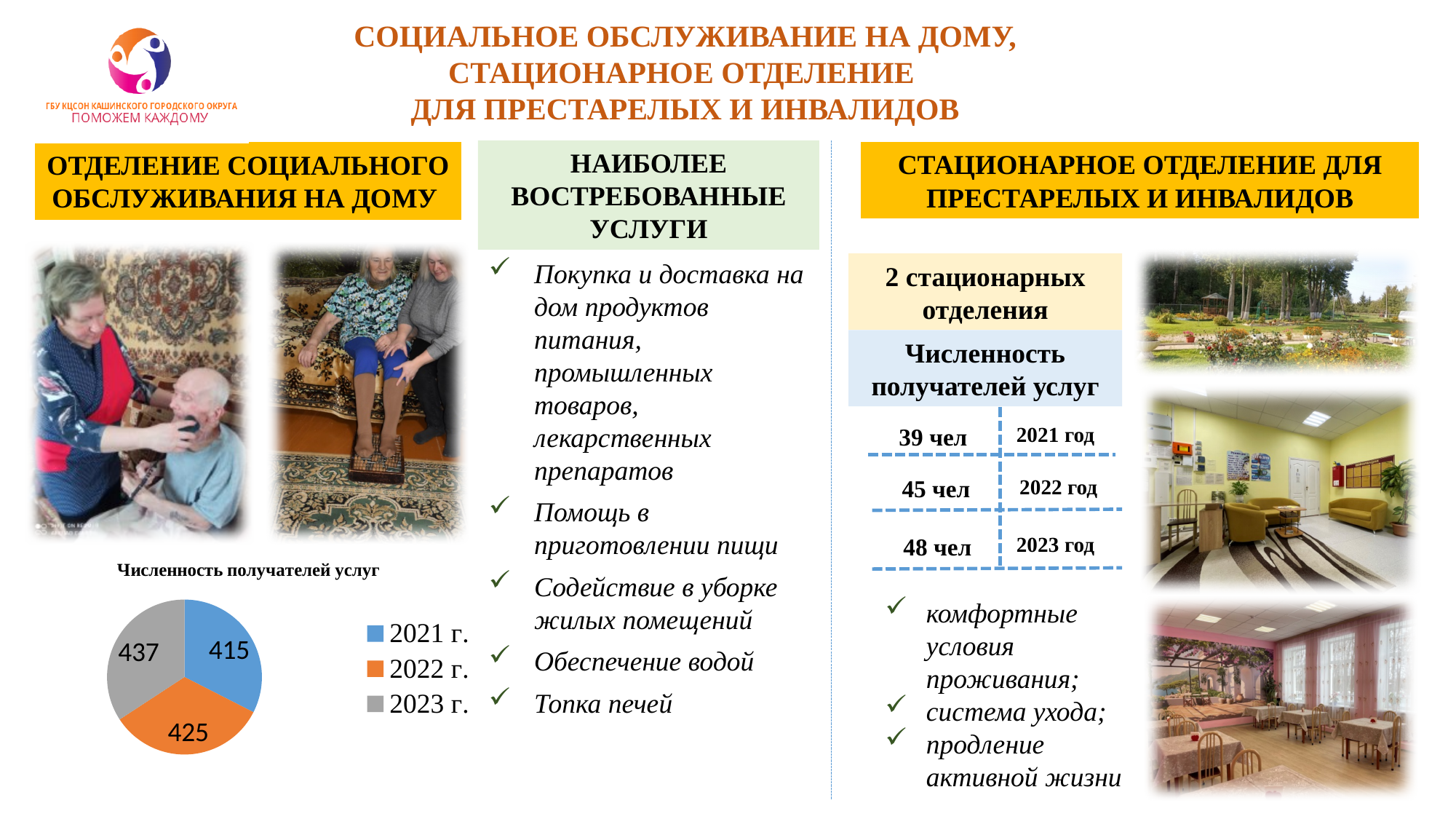
How many entries does the legend of the pie chart "Численность получателей услуг" list? 3 In the pie chart "Численность получателей услуг", which year has the largest slice? 2023 г. In the pie chart "Численность получателей услуг", what is the value for 2023 г.? 437 In the pie chart "Численность получателей услуг", what is the value for 2021 г.? 415 What kind of chart is shown under the heading "Численность получателей услуг" on the left of the slide? pie chart In the pie chart "Численность получателей услуг", what is the difference between the values for 2022 г. and 2021 г.? 10 In the pie chart "Численность получателей услуг", what is the value for 2022 г.? 425 In the pie chart "Численность получателей услуг", which year has the smallest slice? 2021 г. In the pie chart "Численность получателей услуг", what is the difference between the values for 2023 г. and 2021 г.? 22 How many slices does the pie chart "Численность получателей услуг" have? 3 In the pie chart "Численность получателей услуг", which is larger: the value for 2022 г. or the value for 2023 г.? 2023 г. In the pie chart "Численность получателей услуг", what colour is the slice for 2022 г.? orange